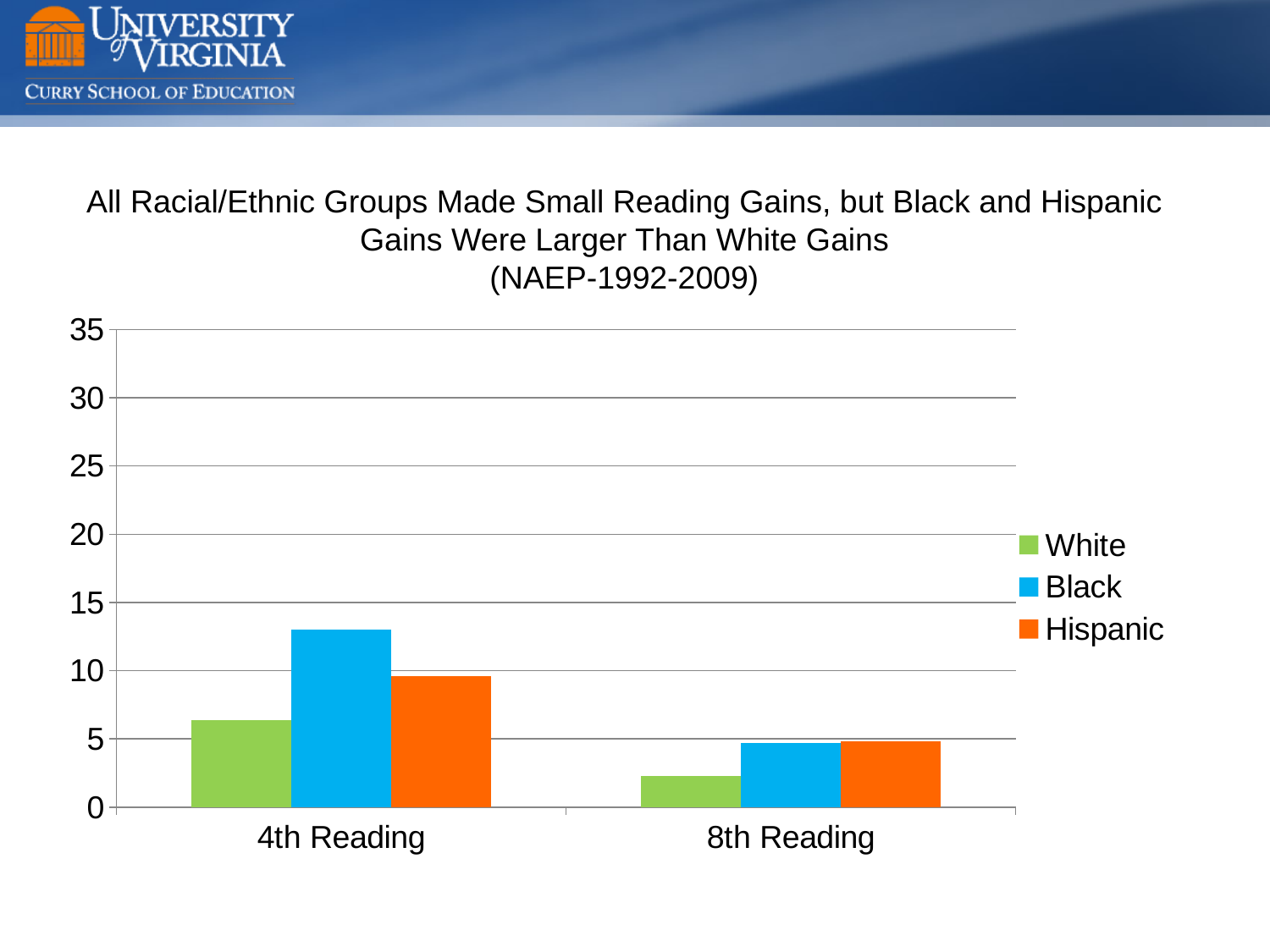
Do the values for each group rise or fall from 4th Reading to 8th Reading? fall Is the Black value for 4th Reading greater or less than 10? greater Which colour represents Hispanic in the legend? orange Is the White value for 4th Reading greater or less than 5? greater Which group has the highest value for 4th Reading? Black Which group has the lowest value for 4th Reading? White For 4th Reading, which is larger, the Black value or the Hispanic value? Black What kind of chart is shown on the slide? bar chart Which group has the lowest value for 8th Reading? White How many series does the legend list? 3 How many categories are shown on the x axis? 2 Is the White value for 8th Reading greater or less than 5? less